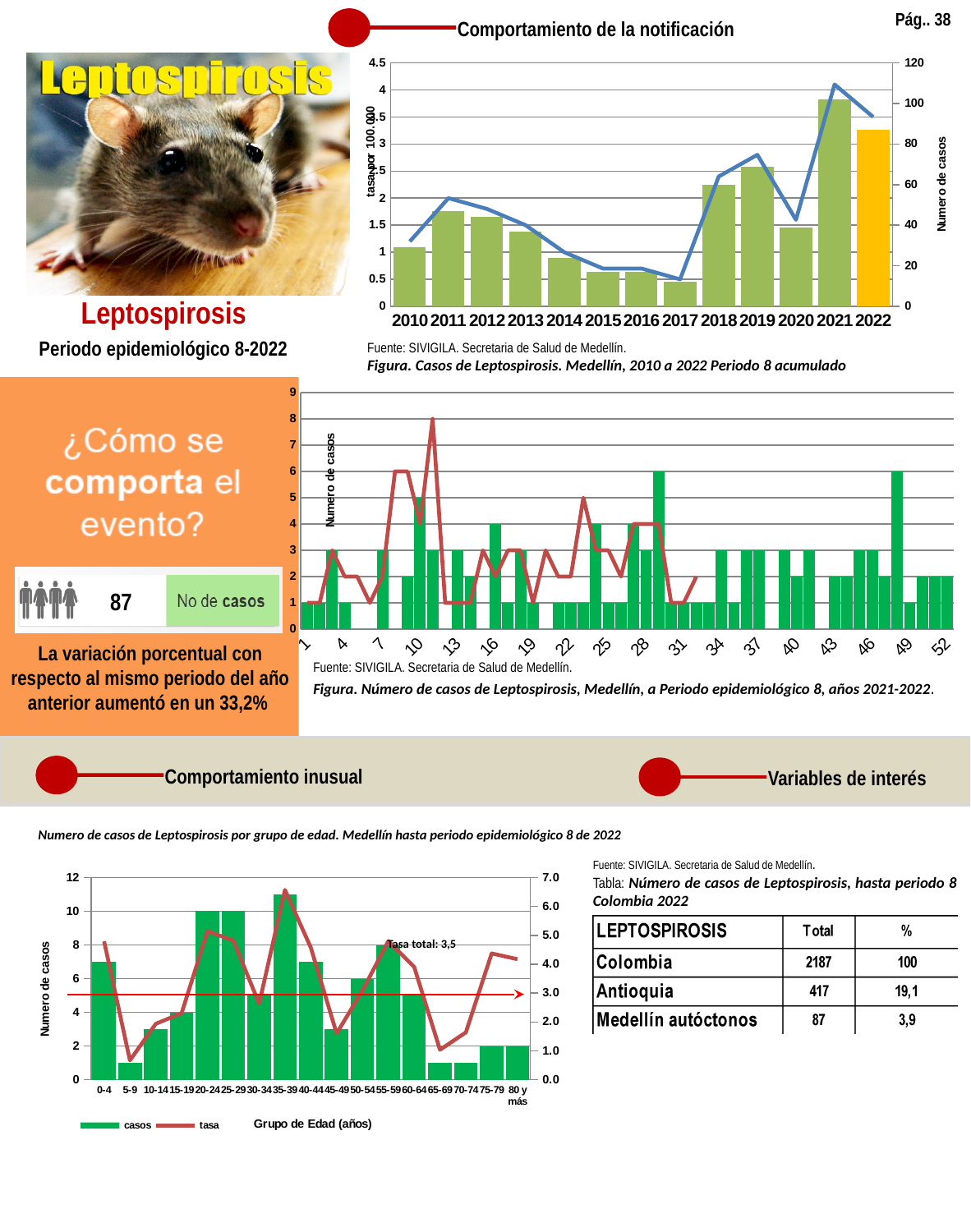
In the top-right chart 'Casos de Leptospirosis. Medellín, 2010 a 2022', which year has the shortest bar? 2017 In the top-right chart 'Casos de Leptospirosis. Medellín, 2010 a 2022', is the bar for 2017 greater or less than 20 on the right-hand axis? less In the bottom-left chart by age group, which age group has the tallest bar for casos? 35-39 In the top-right chart 'Casos de Leptospirosis. Medellín, 2010 a 2022', which bar is coloured differently (orange) from the others? 2022 In the bottom-left chart by age group, what is the number of casos for the 20-24 age group? 10 In the top-right chart 'Casos de Leptospirosis. Medellín, 2010 a 2022', how many years are shown on the x axis? 13 In the bottom-left chart by age group, what is the 'Tasa total' value printed on the chart? 3,5 In the top-right chart 'Casos de Leptospirosis. Medellín, 2010 a 2022', is the bar for 2018 larger or smaller than the bar for 2020? larger In the top-right chart 'Casos de Leptospirosis. Medellín, 2010 a 2022', which year has the tallest bar? 2021 In the middle chart 'Número de casos de Leptospirosis, Medellín, a Periodo epidemiológico 8, años 2021-2022', what is the highest value reached by the red line? 8 What kind of chart is the bottom-left chart 'Numero de casos de Leptospirosis por grupo de edad'? Bar chart with a line In the bottom-left chart by age group, how many series does the legend list? 2